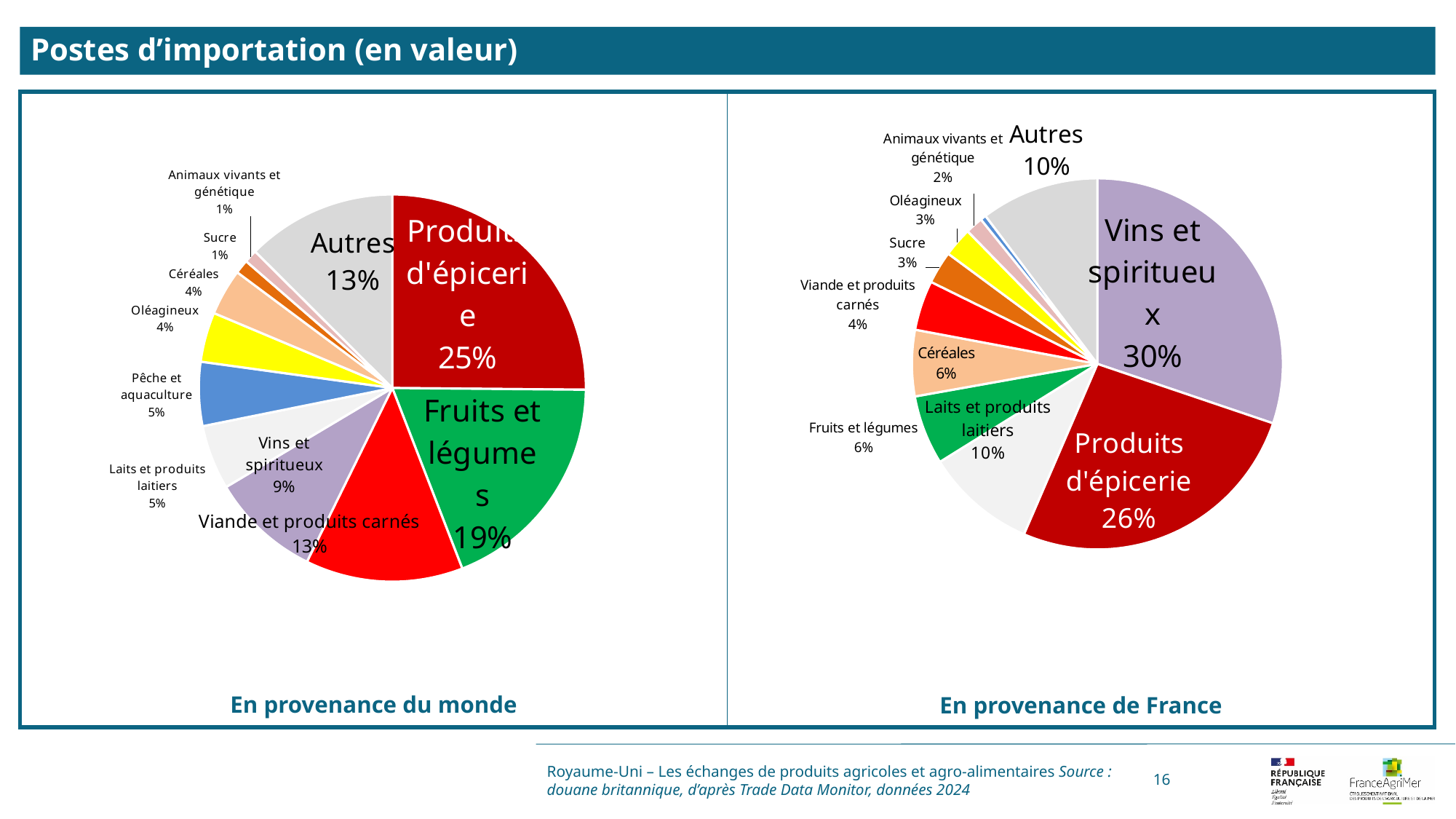
In the 'En provenance de France' pie chart, which category has the largest share? Vins et spiritueux In the 'En provenance du monde' pie chart, what is the difference between the shares of Produits d'épicerie and Fruits et légumes? 6 percentage points In the 'En provenance de France' pie chart, what share is Vins et spiritueux? 30% In the 'En provenance de France' pie chart, what share is Laits et produits laitiers? 10% What type of chart is used on this slide? Pie chart In the 'En provenance du monde' pie chart, which category has the largest share? Produits d'épicerie In the 'En provenance du monde' pie chart, what share is Viande et produits carnés? 13% In the 'En provenance de France' pie chart, what is the difference between the shares of Vins et spiritueux and Produits d'épicerie? 4 percentage points Which is larger: the share of Vins et spiritueux in the 'En provenance du monde' chart or in the 'En provenance de France' chart? En provenance de France In the 'En provenance du monde' pie chart, what share is Produits d'épicerie? 25%